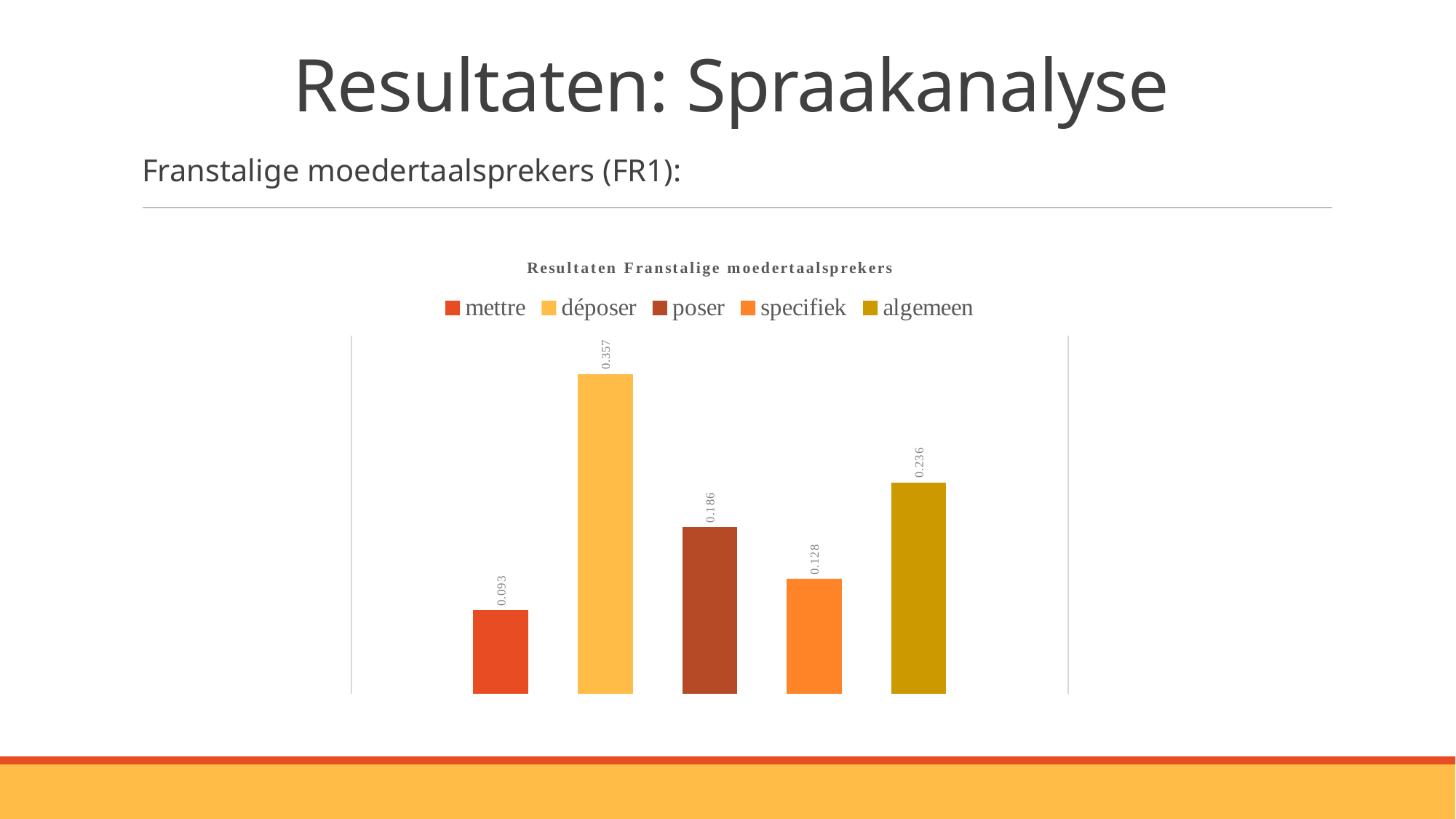
What is the value for algemeen? 0.236 Which is larger, the value for poser or the value for specifiek? poser Which series has the highest value? déposer What is the value for specifiek? 0.128 How many series does the legend list? 5 What is the value for mettre? 0.093 Which series has the lowest value? mettre What is the value for déposer? 0.357 What kind of chart is shown on the slide? bar chart How many bars are plotted in the chart? 5 What is the difference between the values for déposer and poser? 0.171 What is the difference between the values for algemeen and specifiek? 0.108